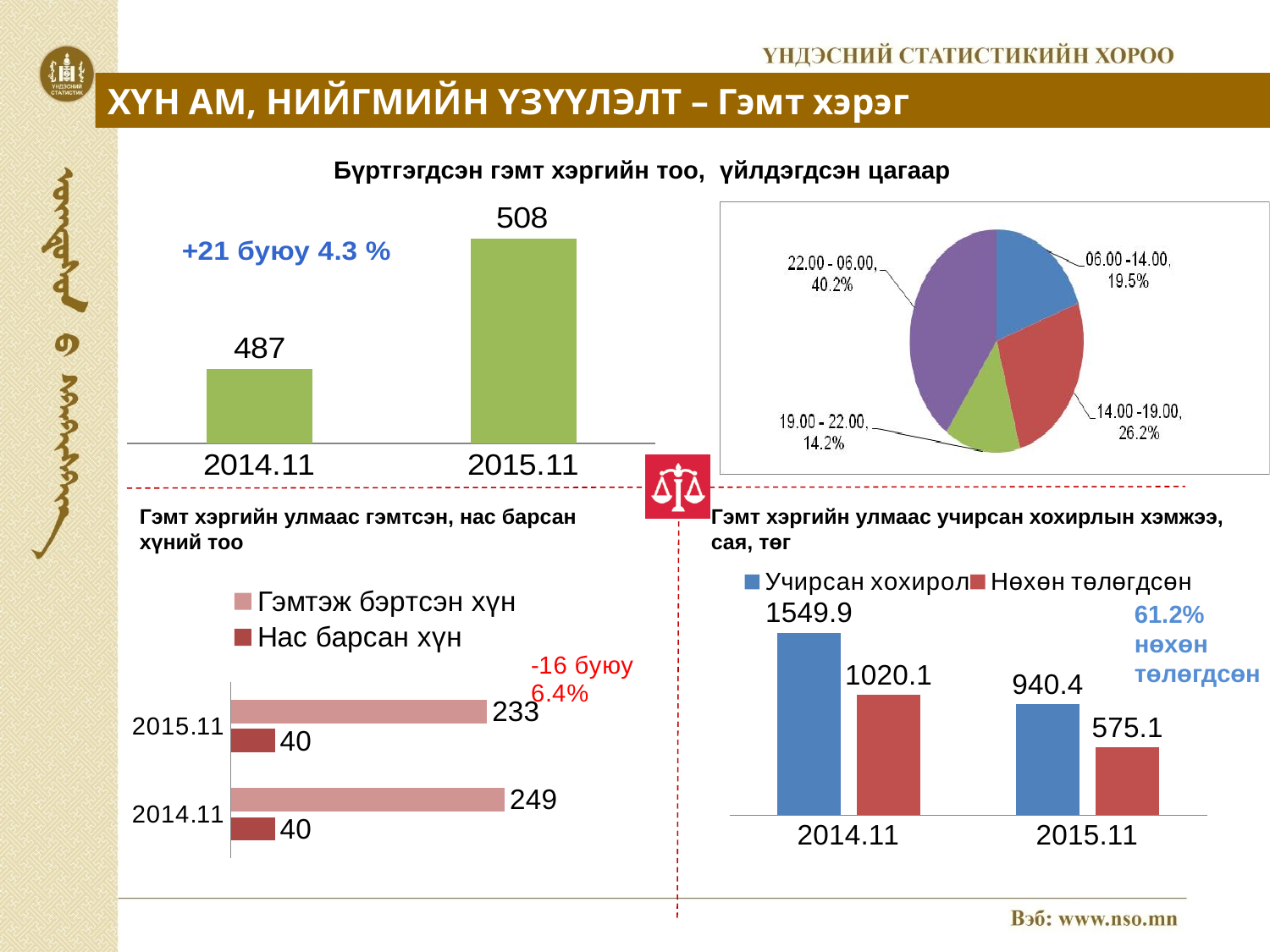
In the bottom-right bar chart of crime damage, what is the value for Учирсан хохирол in 2014.11? 1549.9 In the top-right pie chart of crimes by time of day, which time slot has the largest share? 22.00 - 06.00 In the top-right pie chart of crimes by time of day, which time slot has the smallest share? 19.00 - 22.00 In the top-left bar chart of registered crimes, what is the value for 2014.11? 487 In the top-right pie chart of crimes by time of day, what is the share for 14.00 - 19.00? 26.2% In the top-left bar chart of registered crimes, what is the value for 2015.11? 508 In the top-left bar chart of registered crimes, what is the difference between the 2015.11 and 2014.11 values? 21 In the bottom-left bar chart of injured and deceased persons, what is the value for Нас барсан хүн in 2015.11? 40 In the bottom-left bar chart of injured and deceased persons, what is the value for Гэмтэж бэртсэн хүн in 2014.11? 249 How many slices does the top-right pie chart have? 4 How many series does the legend of the bottom-left bar chart list? 2 In the bottom-right bar chart of crime damage, which is larger: Нөхөн төлөгдсөн in 2014.11 or Нөхөн төлөгдсөн in 2015.11? 2014.11